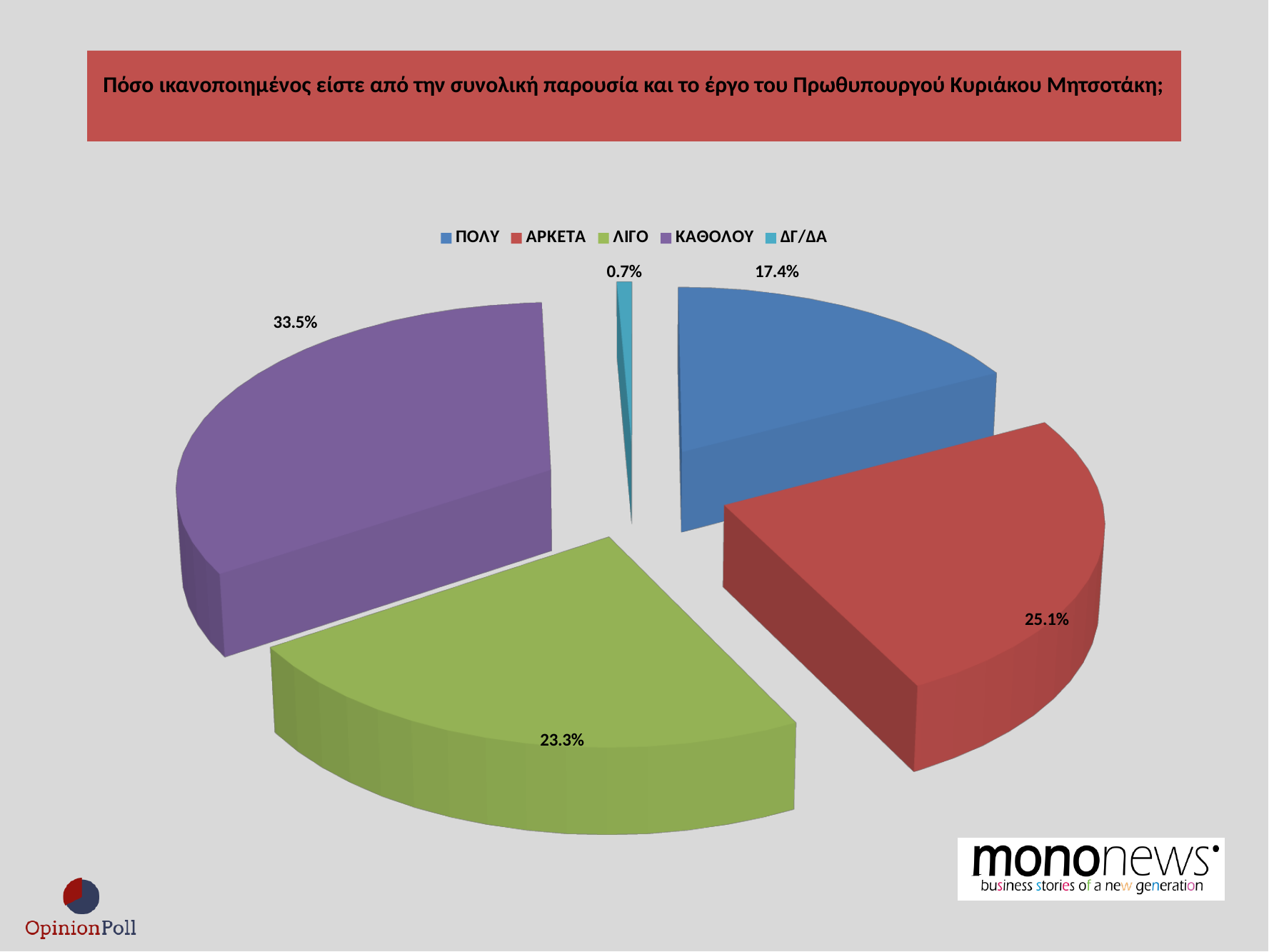
What percentage of respondents answered ΔΓ/ΔΑ? 0.7% How many categories does the pie chart show? 5 What percentage of respondents answered ΑΡΚΕΤΑ? 25.1% What percentage of respondents answered ΛΙΓΟ? 23.3% Which is larger, the share for ΑΡΚΕΤΑ or the share for ΛΙΓΟ? ΑΡΚΕΤΑ What percentage of respondents answered ΚΑΘΟΛΟΥ? 33.5% What is the difference in percentage points between ΚΑΘΟΛΟΥ and ΠΟΛΥ? 16.1 Which response category has the smallest share? ΔΓ/ΔΑ What colour is the ΚΑΘΟΛΟΥ slice? Purple What percentage of respondents answered ΠΟΛΥ? 17.4% Which response category has the largest share? ΚΑΘΟΛΟΥ What kind of chart is shown on the slide? Pie chart